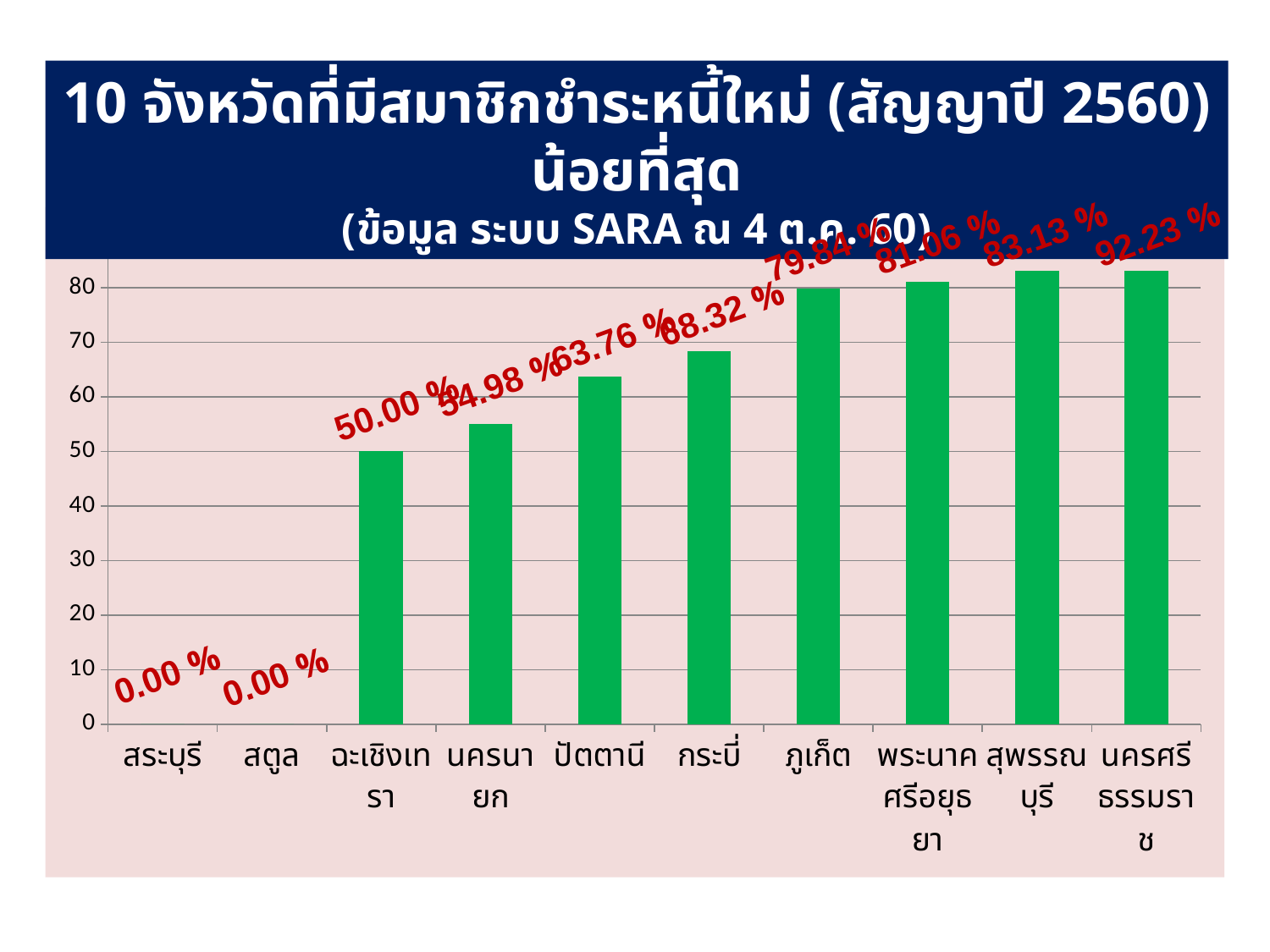
What type of chart is shown on the slide? bar chart What is the difference between the values for ปัตตานี and นครนายก? 8.78 % What is the value shown for ฉะเชิงเทรา? 50.00 % What is the value shown for ภูเก็ต? 79.84 % Which is larger, the value for สุพรรณบุรี or the value for พระนครศรีอยุธยา? สุพรรณบุรี Is the value for นครนายก greater or less than 50? greater What is the value shown for สระบุรี? 0.00 % How many provinces are shown on the x axis of the chart? 10 Which province has the highest value in the chart? นครศรีธรรมราช What is the value shown for กระบี่? 68.32 % Do the values generally rise or fall from left to right along the x axis? rise What colour are the bars in the chart? green